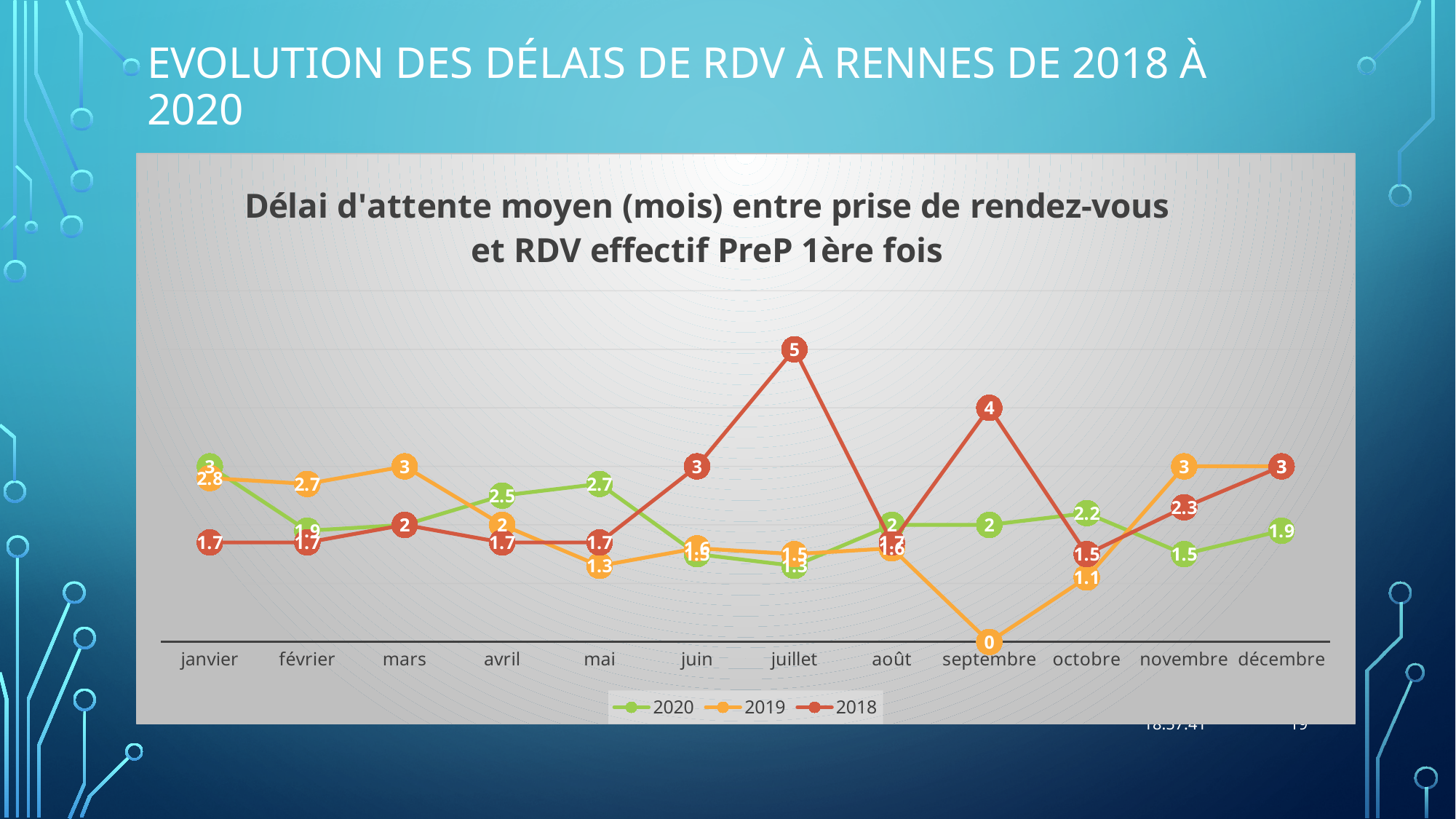
What is the value for 2020 in mai? 2.7 In janvier, which series has the larger value, 2020 or 2018? 2020 What is the value for 2018 in juillet? 5 What is the value for 2019 in septembre? 0 What is the difference between the 2018 values for juillet and septembre? 1 What kind of chart is shown on the slide? line chart What is the value for 2019 in octobre? 1.1 In which month is the 2019 series lowest? septembre Which series is drawn in green? 2020 How many series does the legend list? 3 In which month is the 2018 series highest? juillet How many months are shown along the x axis? 12